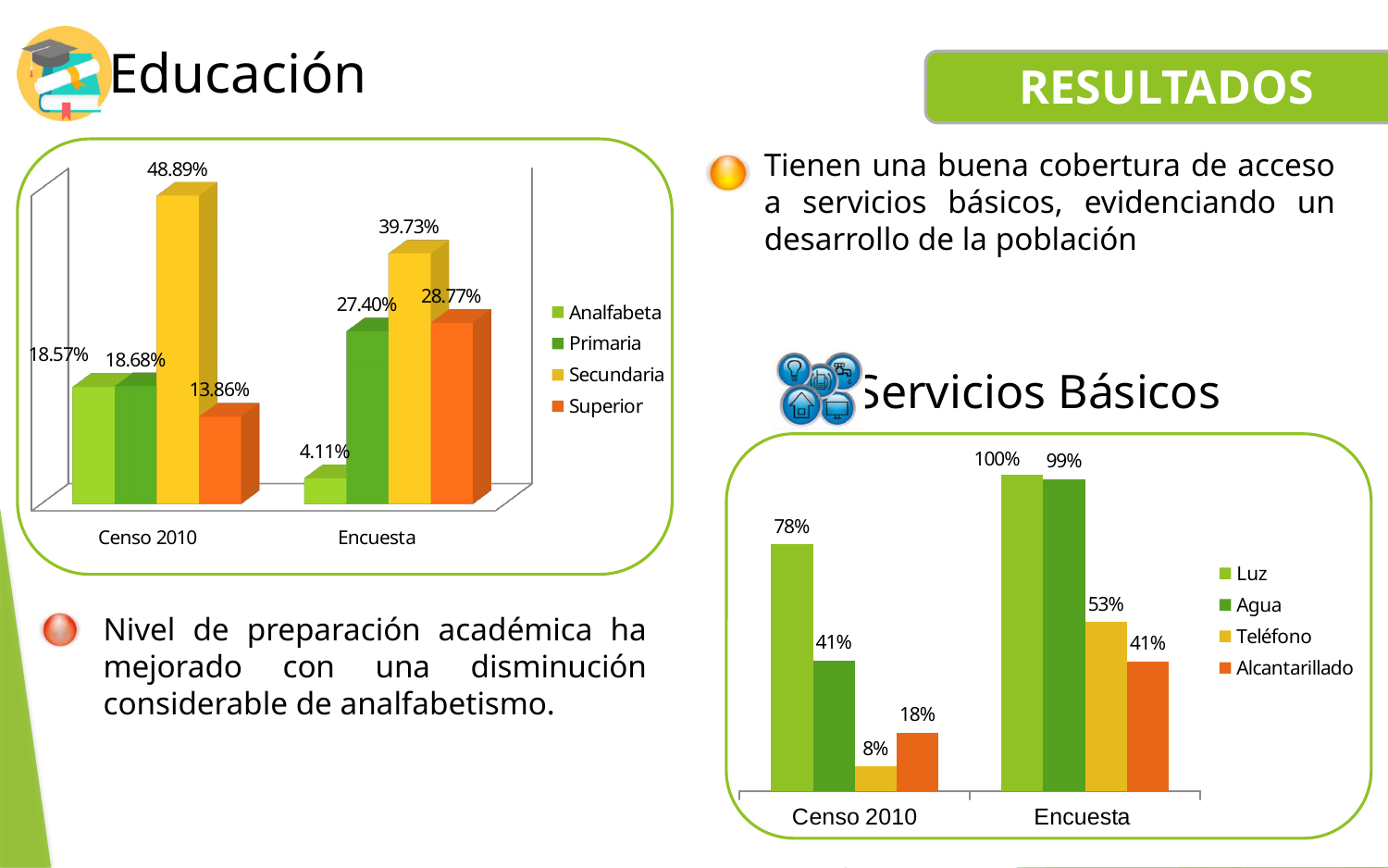
In the Educación chart, which series has the lowest value in Encuesta? Analfabeta In the Educación chart, which is larger: Superior in Censo 2010 or Superior in Encuesta? Superior in Encuesta In the Educación chart, what is the value for Secundaria in Censo 2010? 48.89% What kind of chart is the Servicios Básicos chart? Bar chart In the Educación chart, what is the value for Analfabeta in Encuesta? 4.11% In the Servicios Básicos chart, what is the difference between the Alcantarillado values for Encuesta and Censo 2010? 23% In the Servicios Básicos chart, how many categories are shown on the x axis? 2 In the Servicios Básicos chart, which series has the highest value in Encuesta? Luz In the Educación chart, how many series does the legend list? 4 In the Educación chart, what is the difference between the Analfabeta values for Censo 2010 and Encuesta? 14.46% In the Servicios Básicos chart, what is the value for Agua in Encuesta? 99% In the Servicios Básicos chart, what is the value for Teléfono in Censo 2010? 8%